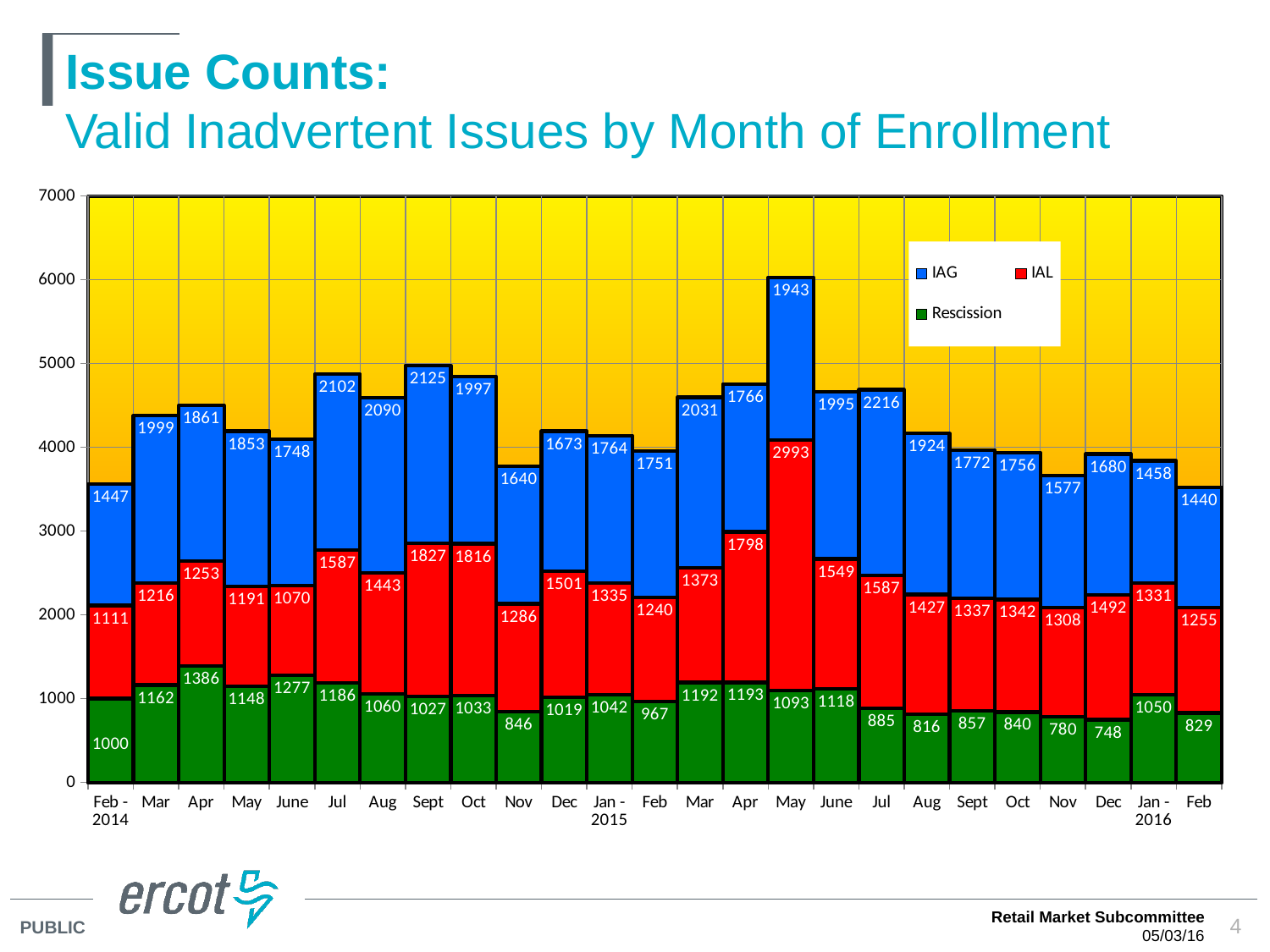
Which month has the lowest Rescission value? Dec 2015 What is the total of the stacked bar for Feb 2014? 3558 What is the IAL value for May 2015? 2993 What is the IAG value for Jul 2015? 2216 Which month has the highest IAL value? May 2015 What is the Rescission value for Feb 2014? 1000 How many months are shown on the x axis? 25 Which is larger, the Rescission value for Apr 2014 or for Jan 2016? Apr 2014 What kind of chart is shown on the slide? Stacked bar chart What is the total of the stacked bar for May 2015? 6029 What is the difference between the IAG values for Sept 2014 and Feb 2016? 685 How many series does the legend list? 3